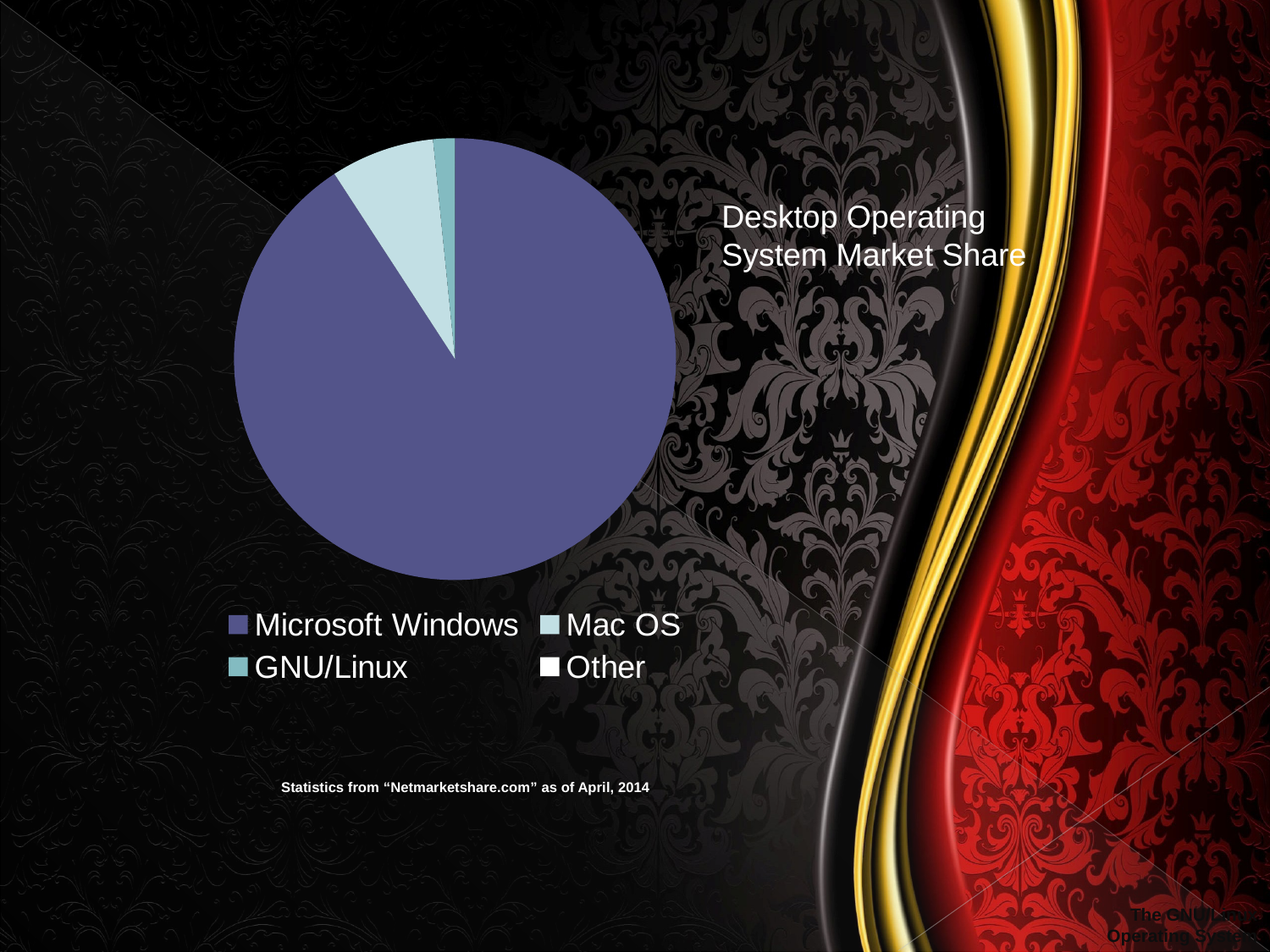
What are the four categories listed in the legend? Microsoft Windows, Mac OS, GNU/Linux, Other Which has a larger share, Microsoft Windows or Mac OS? Microsoft Windows What kind of chart is shown on the slide? Pie chart How many categories does the pie chart show? 4 Which has a larger share, Mac OS or GNU/Linux? Mac OS Which category has the largest share of the pie? Microsoft Windows Which has a smaller share, GNU/Linux or Microsoft Windows? GNU/Linux What is the title of the chart? Desktop Operating System Market Share